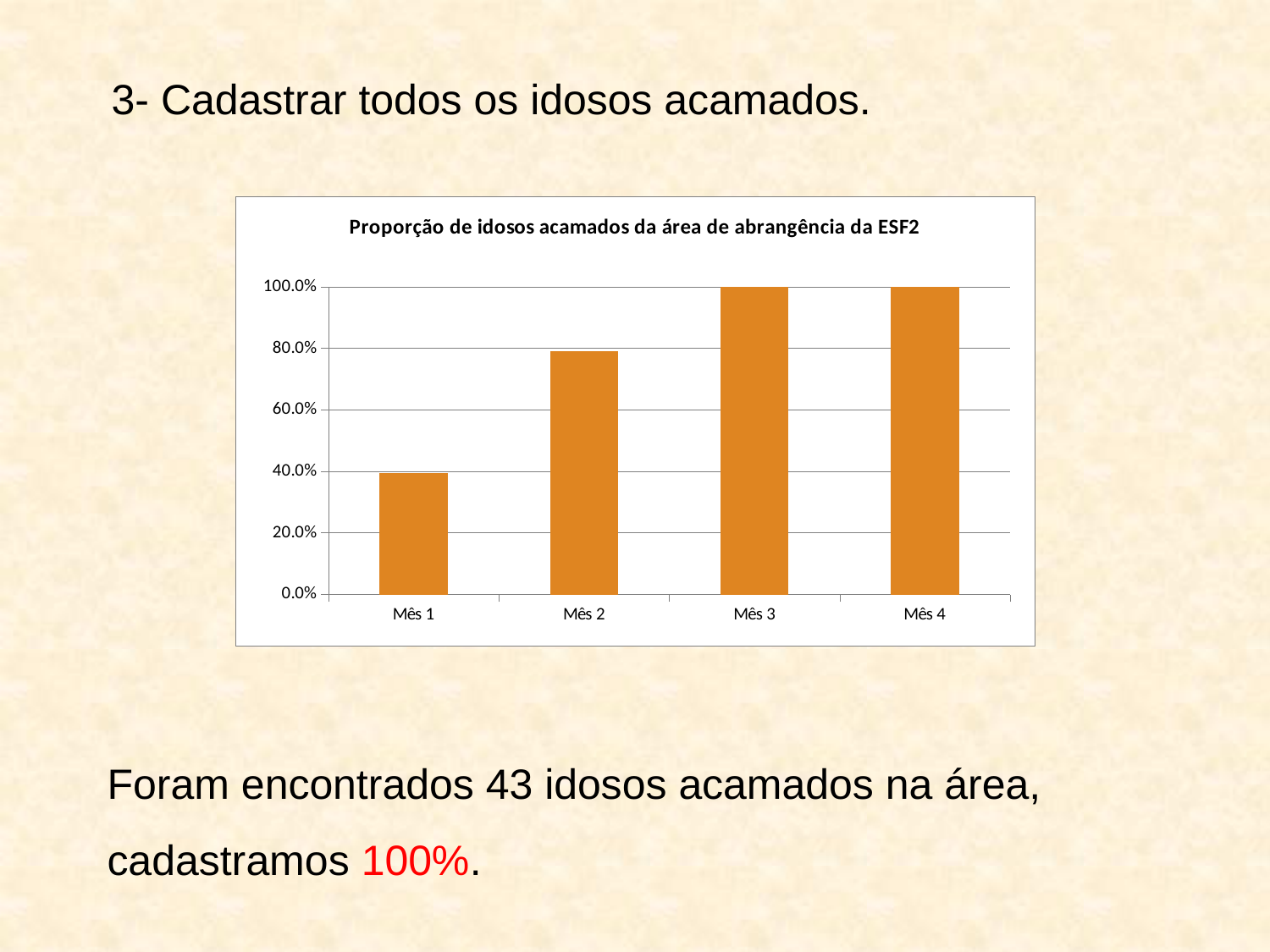
Do the values rise or fall from Mês 1 to Mês 3? Rise What is the value for Mês 4? 100.0% How many months (categories) are shown on the x axis of the chart? 4 Is the value for Mês 1 greater or less than 60.0%? less Is the value for Mês 2 greater or less than 60.0%? greater What is the value for Mês 3? 100.0% What is the highest value shown on the y axis of the chart? 100.0% Which month has the lowest value? Mês 1 Is the value for Mês 1 greater or less than 20.0%? greater Which is larger, the value for Mês 1 or the value for Mês 2? Mês 2 What kind of chart is shown on the slide? Bar chart What is the title of the chart? Proporção de idosos acamados da área de abrangência da ESF2